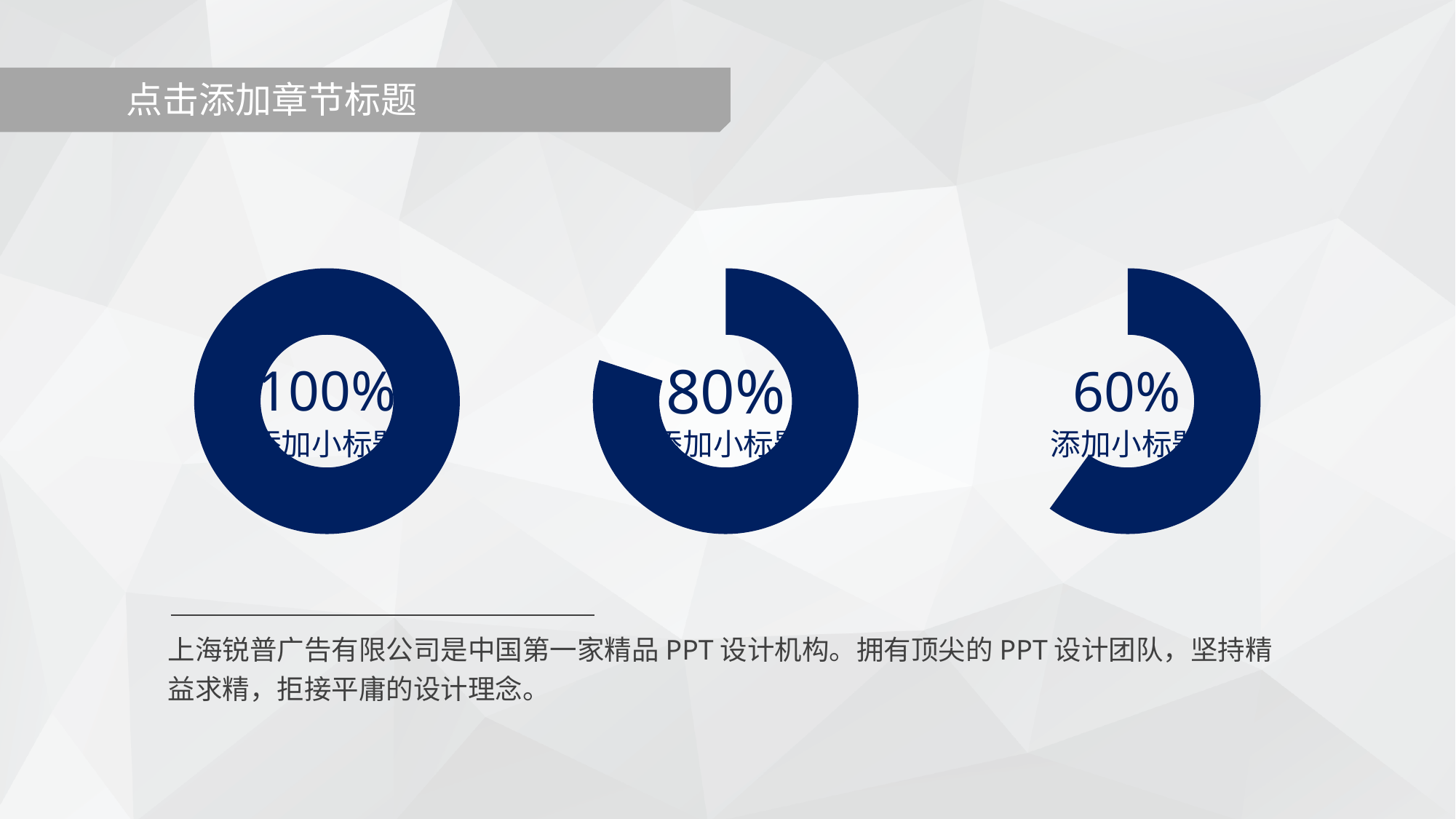
What colour are the filled rings of the donut charts? Dark blue What is the difference between the value in the left donut chart and the value in the middle donut chart? 20% What is the difference between the value in the middle donut chart and the value in the right donut chart? 20% Do the values of the donut charts rise or fall from left to right across the slide? Fall Which of the three donut charts shows the lowest value? The right chart (60%) Is the value in the middle donut chart larger or smaller than the value in the right donut chart? Larger How many donut charts are on the slide? 3 What value is shown in the right donut chart? 60% Which of the three donut charts shows the highest value? The left chart (100%) What value is shown in the middle donut chart? 80% What kind of chart is used to display the percentages on the slide? Donut chart What value is shown in the left donut chart? 100%